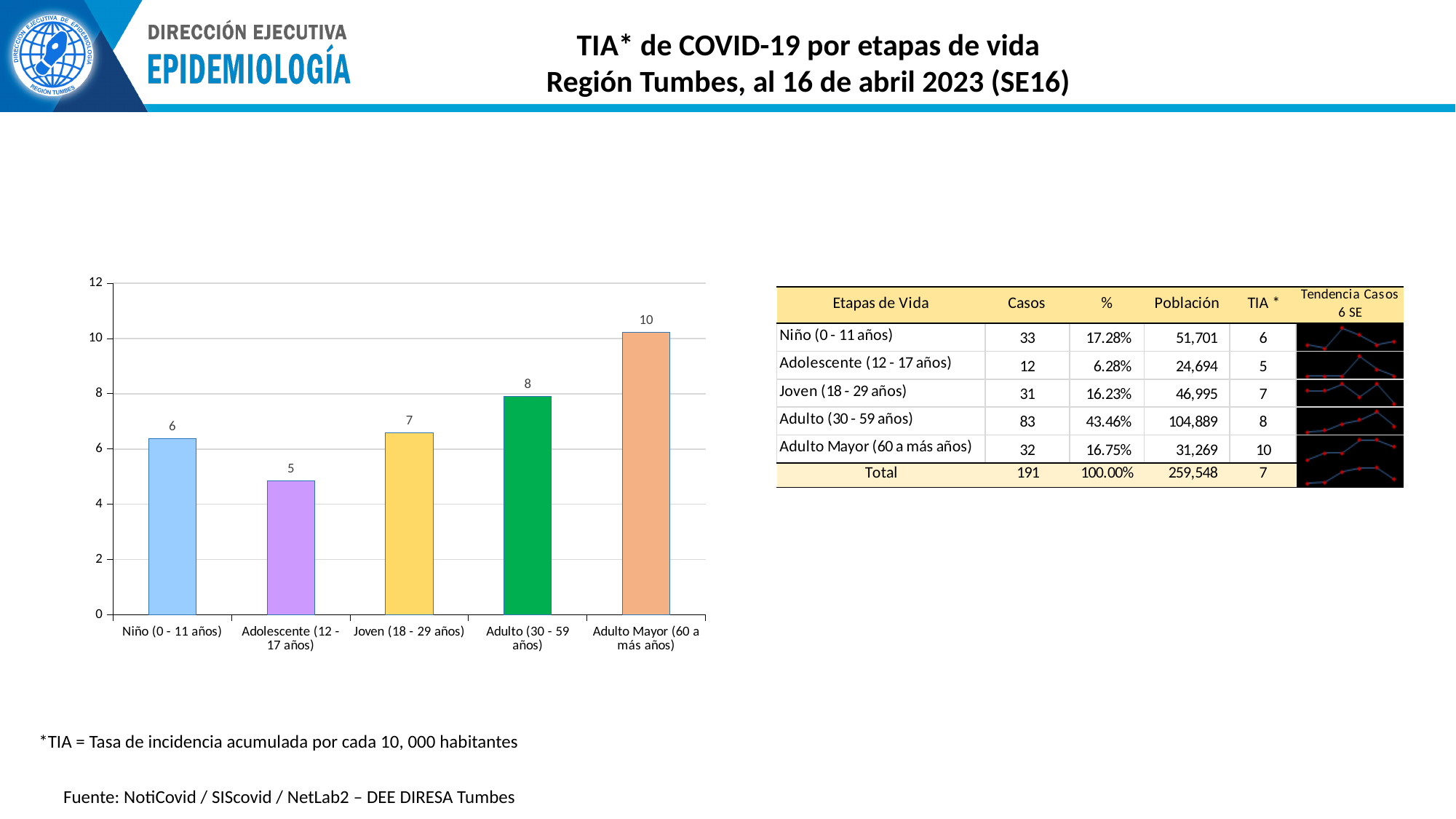
What is the difference between the labelled values for Adulto Mayor (60 a más años) and Adolescente (12 - 17 años)? 5 Which category has the highest bar in the chart? Adulto Mayor (60 a más años) What is the value labelled on the bar for Adulto Mayor (60 a más años)? 10 Which has a larger value, Joven (18 - 29 años) or Adulto (30 - 59 años)? Adulto (30 - 59 años) Is the bar for Adulto (30 - 59 años) greater or less than 6? greater Which category has the lowest bar in the chart? Adolescente (12 - 17 años) What is the value labelled on the bar for Adolescente (12 - 17 años)? 5 Is the bar for Adolescente (12 - 17 años) greater or less than 6? less What is the maximum value shown on the vertical axis of the bar chart? 12 How many age-group categories are plotted in the bar chart? 5 What type of chart is shown on the slide? bar chart What is the value labelled on the bar for Niño (0 - 11 años)? 6